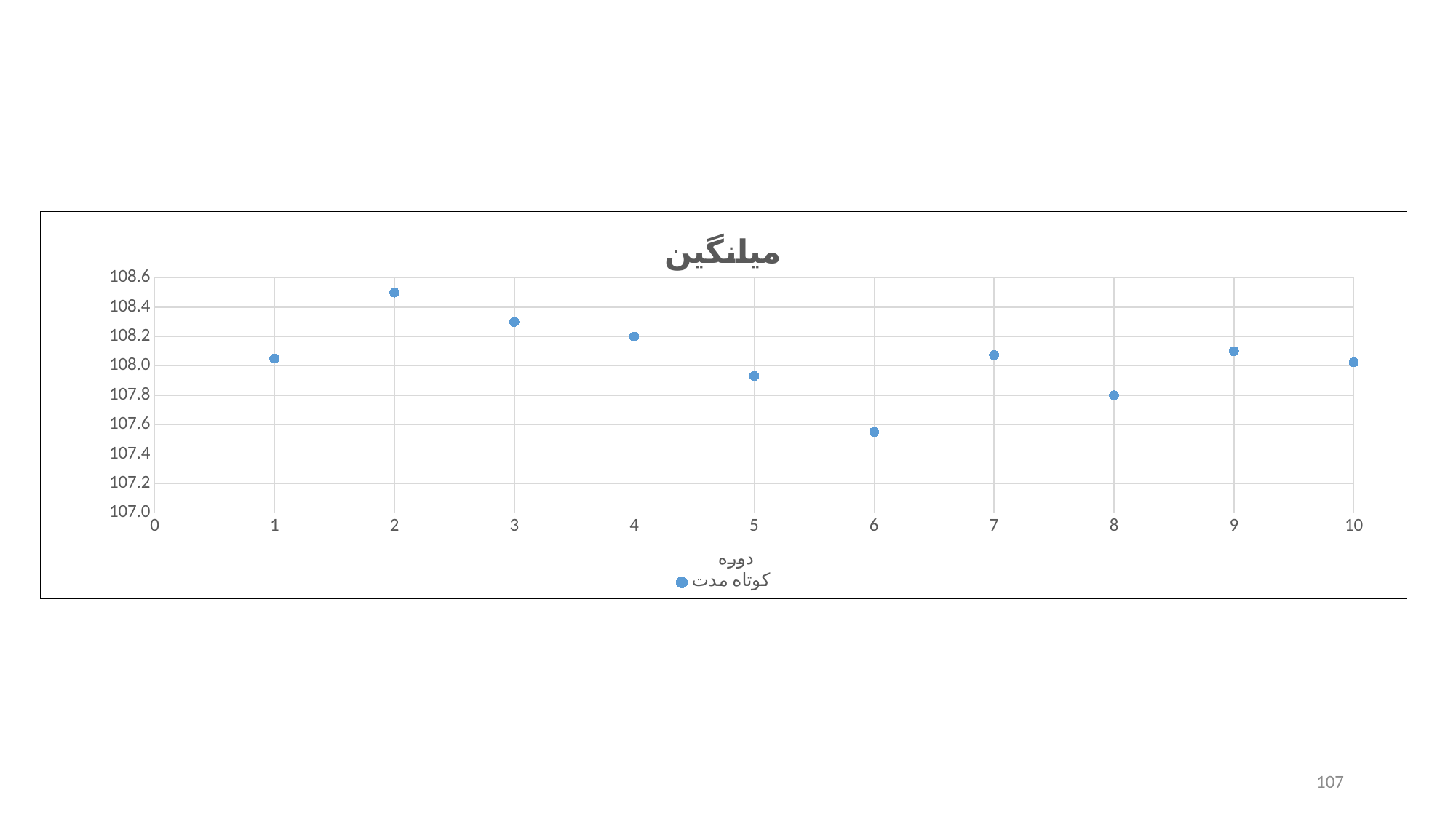
At which period (x value) is the plotted value highest? 2 What kind of chart is shown on the slide? scatter chart What is the title of the chart? میانگین How many data points are plotted on the chart? 10 How many series does the legend list? 1 Is the value at period 2 greater or less than 108.4? greater Which has the larger value, period 3 or period 5? period 3 Which has the larger value, period 8 or period 9? period 9 At which period (x value) is the plotted value lowest? 6 Is the value at period 5 greater or less than 108.0? less What series name does the legend show? کوتاه مدت Is the value at period 6 greater or less than 107.6? less